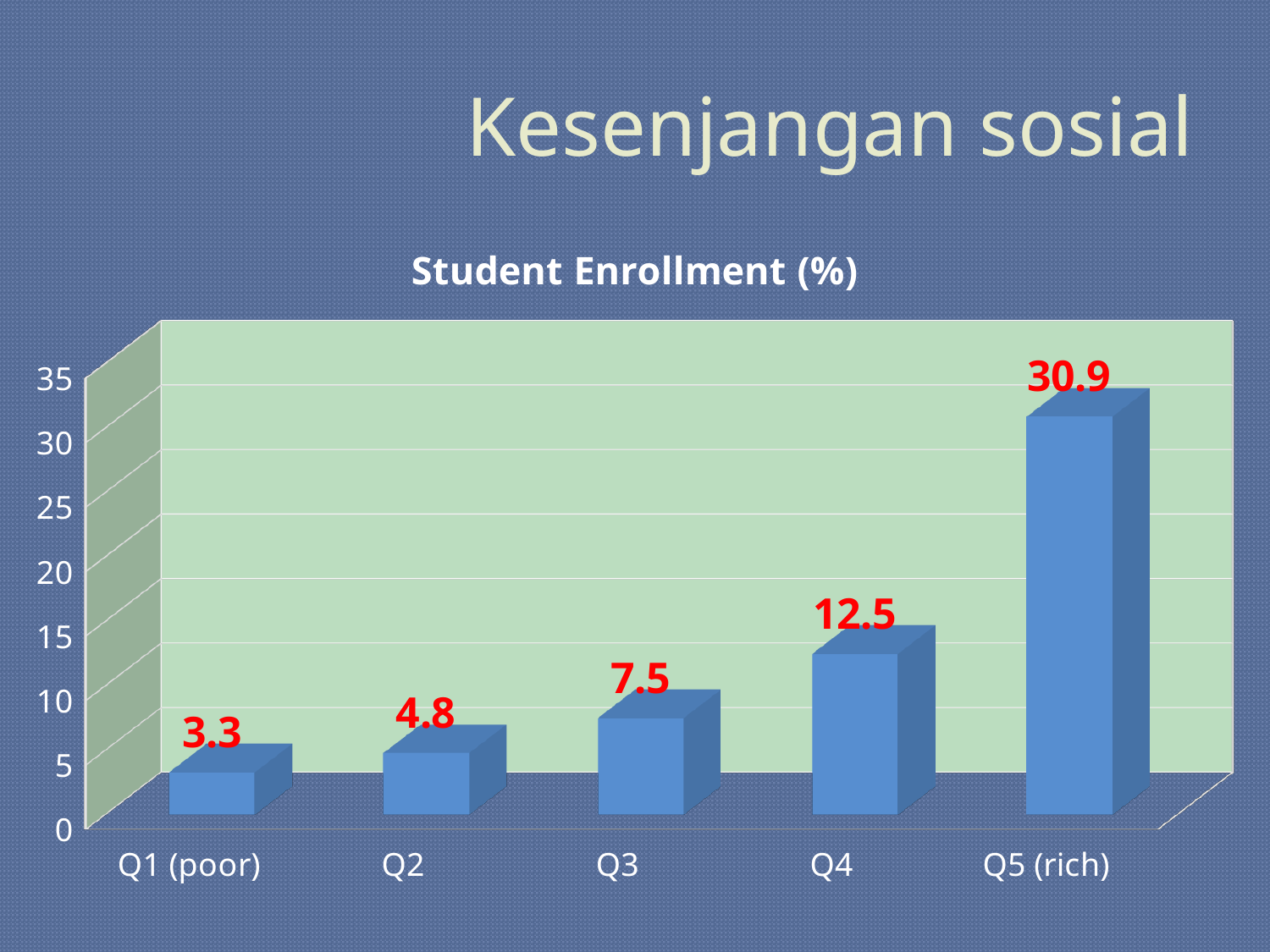
Is the value for Q4 greater or less than 10? greater What is the student enrollment value for Q3? 7.5 How many categories are shown on the x axis? 5 What is the student enrollment value for Q1 (poor)? 3.3 Which category has the highest student enrollment? Q5 (rich) What kind of chart is shown on the slide? bar chart Do the values rise or fall from Q1 (poor) to Q5 (rich)? rise What is the student enrollment value for Q5 (rich)? 30.9 What is the difference between the values for Q4 and Q3? 5 Which is larger, the value for Q2 or the value for Q4? Q4 What is the difference between the values for Q5 (rich) and Q1 (poor)? 27.6 Which category has the lowest student enrollment? Q1 (poor)